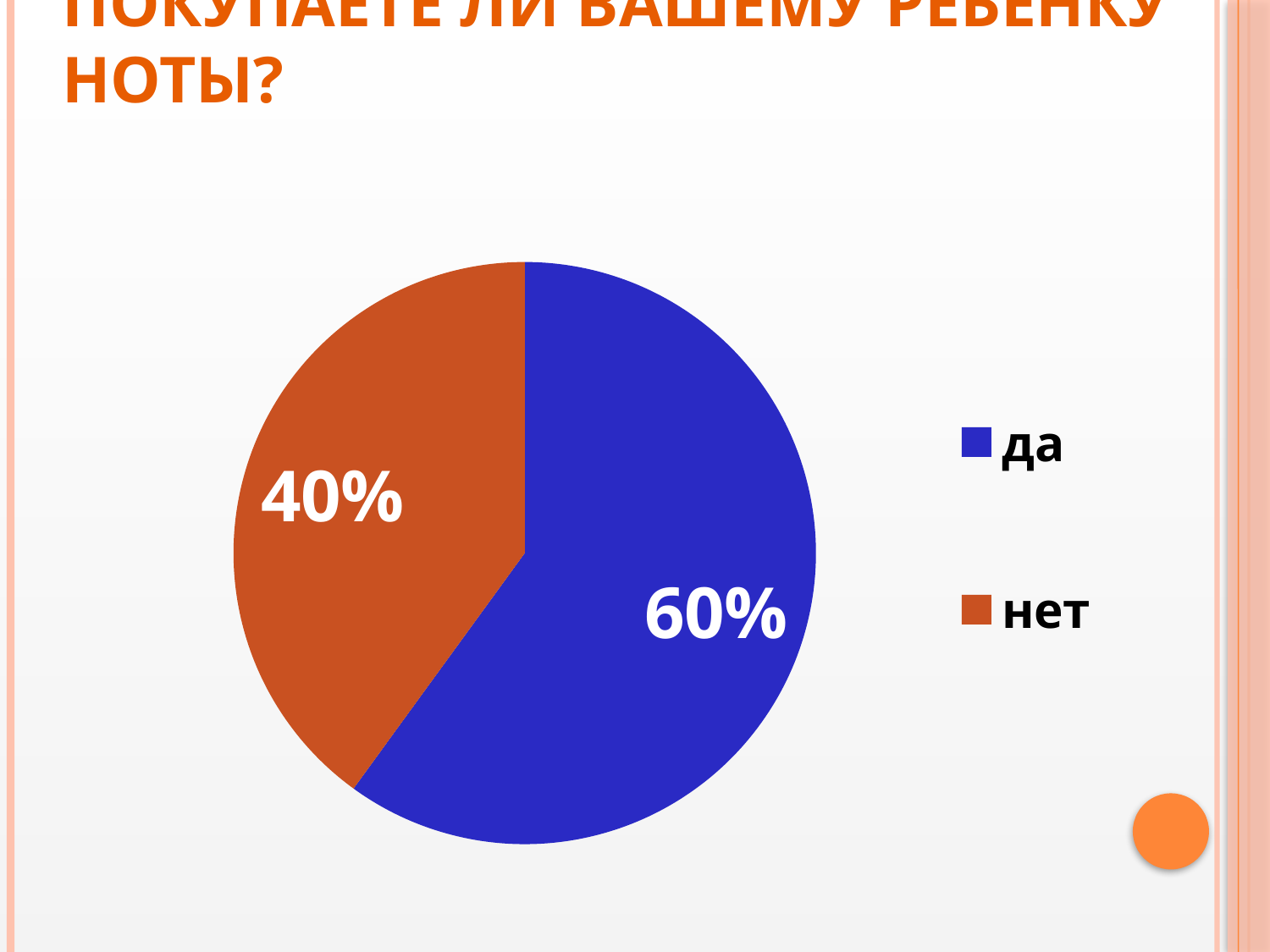
How many slices does the pie chart have? 2 Which slice is larger, "да" or "нет"? да What is the difference in percentage points between the "да" and "нет" slices? 20 What percentage of the pie is labelled "да"? 60% What colour is the "нет" slice? orange Which category has the largest share of the pie? да Is the share for "да" greater or less than 50%? greater Which category has the smallest share of the pie? нет What percentage of the pie is labelled "нет"? 40% What kind of chart is shown on the slide? pie chart How many entries does the legend list? 2 What colour is the "да" slice? blue